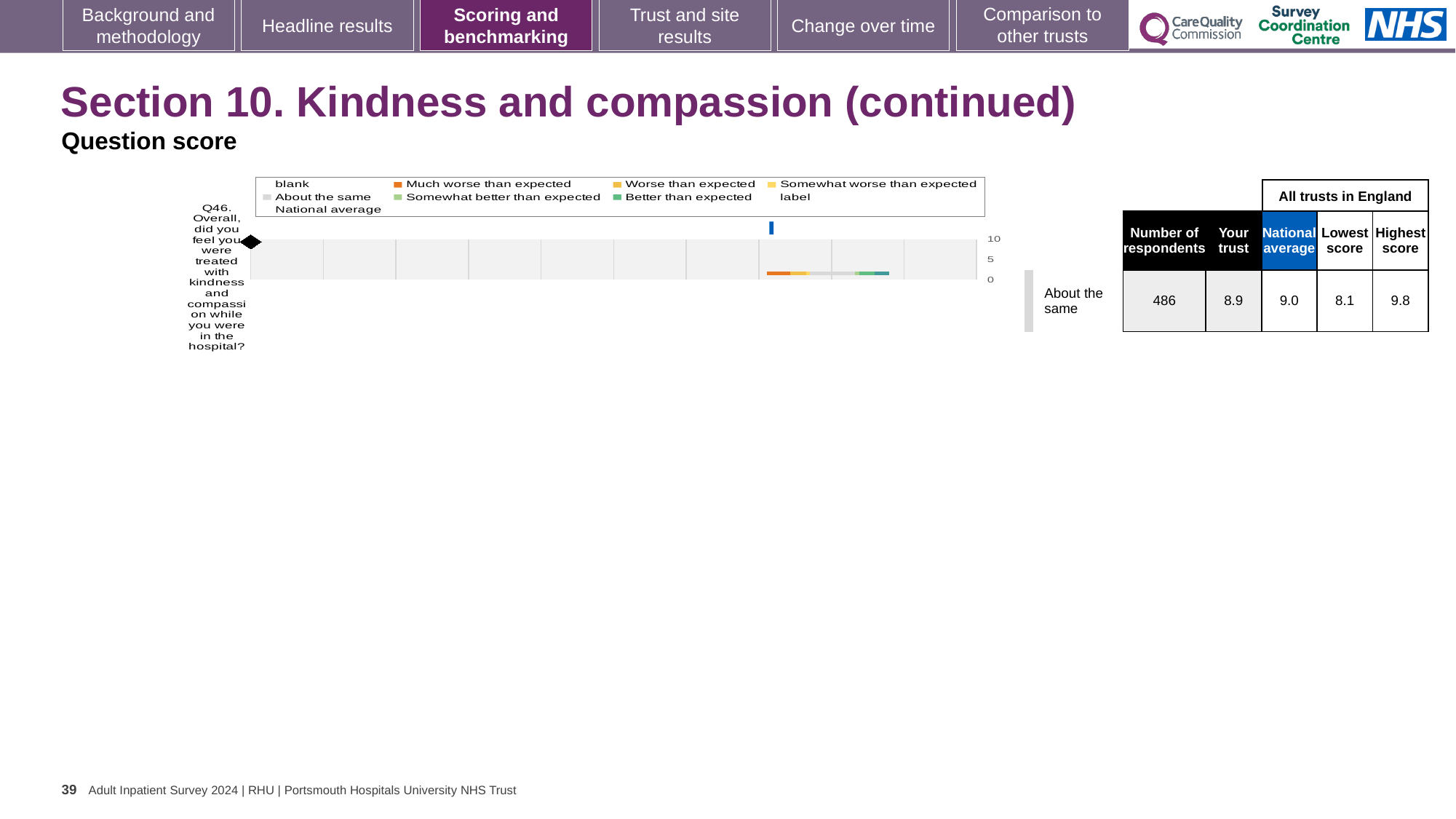
Which is larger for Q46, the 'Your trust' score or the national average? National average Which question number is plotted on the chart? Q46 What is the difference between the highest score and the lowest score for Q46? 1.7 What is the national average score for Q46 shown in the table next to the chart? 9.0 What kind of chart is shown on the slide for Q46? bar chart How many questions (categories) are plotted on the chart? 1 What is the highest score among all trusts in England for Q46? 9.8 What benchmarking category is the trust's Q46 score assigned to on the slide? About the same Is the 'Your trust' score for Q46 greater or less than 5 on the chart's axis? greater What is the 'Your trust' score for Q46 shown in the table next to the chart? 8.9 What is the lowest score among all trusts in England for Q46? 8.1 How many respondents answered Q46? 486